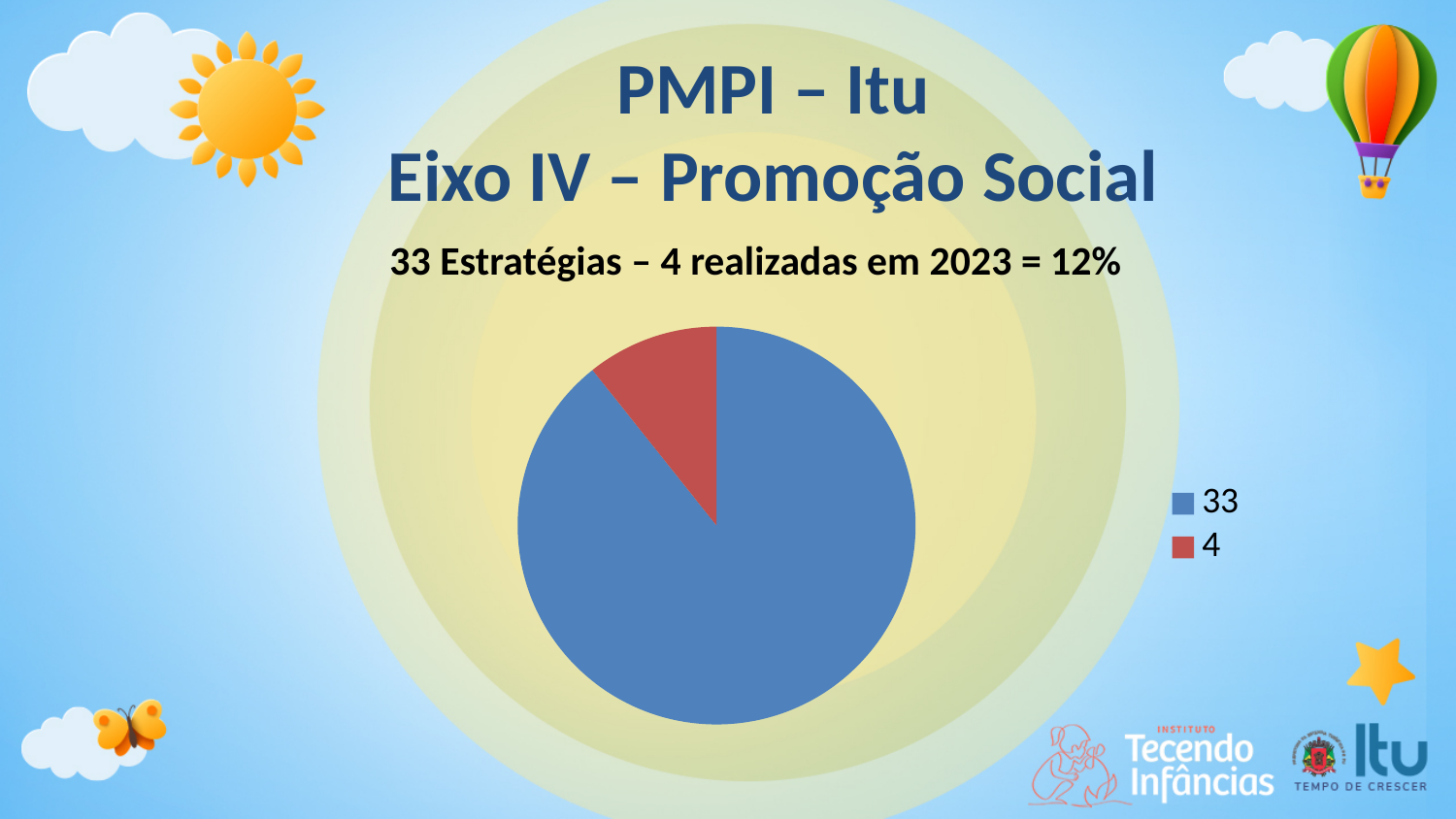
What value does the legend give for the blue slice of the pie chart? 33 Which legend entry corresponds to the smallest slice of the pie chart? 4 What is the difference between the two values shown in the pie chart legend, 33 and 4? 29 What value does the legend give for the red slice of the pie chart? 4 How many slices does the pie chart have? 2 Which legend entry corresponds to the largest slice of the pie chart? 33 What colour is the slice labelled 4 in the pie chart? red Which slice of the pie chart is larger, the one labelled 33 or the one labelled 4? 33 What kind of chart is shown on the slide? pie chart How many entries does the legend of the pie chart list? 2 According to the text above the pie chart, what percentage of the strategies were realized in 2023? 12% What is the title shown above the chart on the slide? PMPI – Itu Eixo IV – Promoção Social